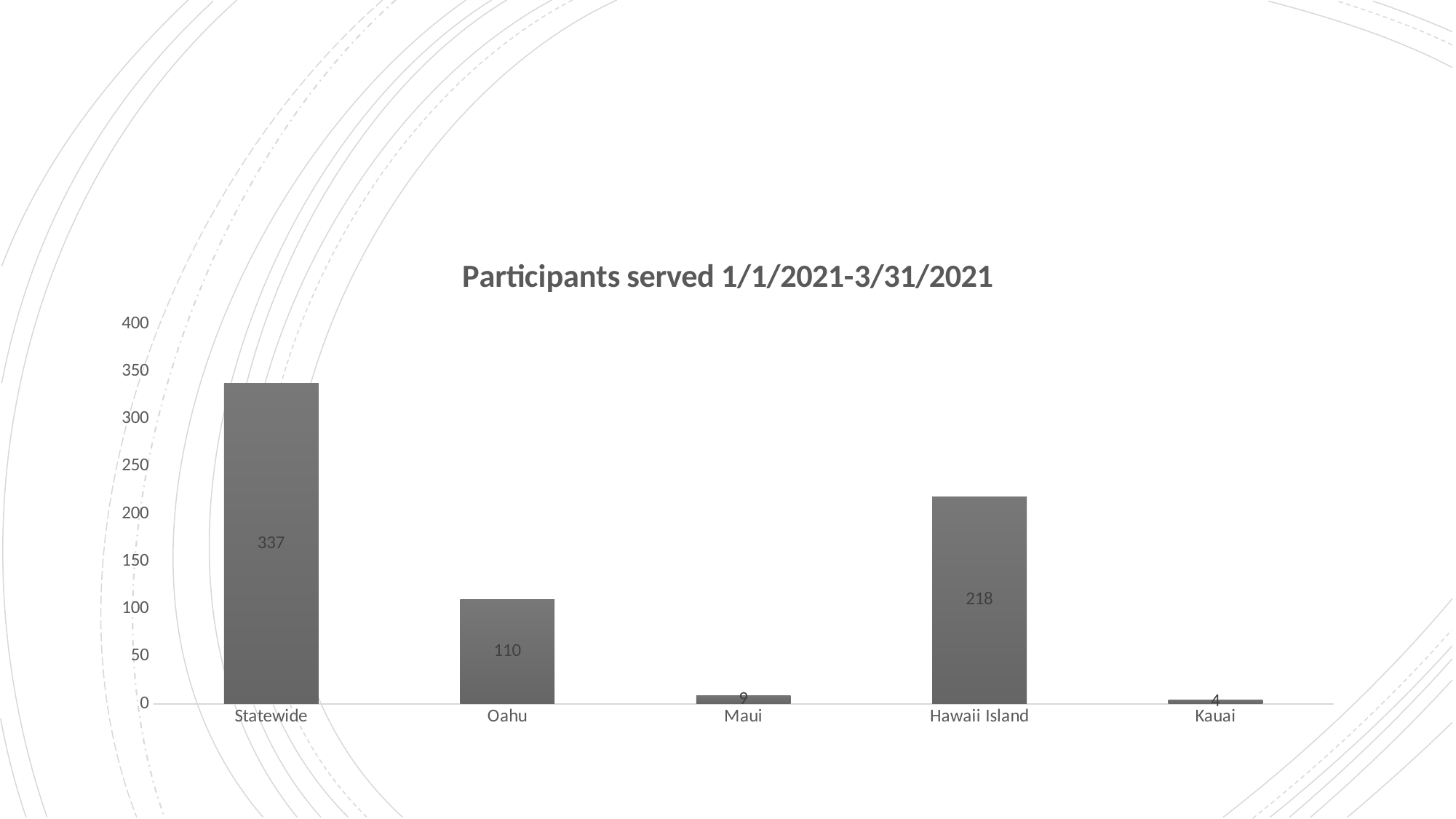
Which is larger, the value for Oahu or the value for Hawaii Island? Hawaii Island Is the value for Statewide greater or less than 300? greater What is the difference between the values for Hawaii Island and Oahu? 108 What is the value for Kauai? 4 What is the value for Statewide? 337 What is the value for Maui? 9 How many categories are shown on the x axis? 5 Which category has the highest value? Statewide What is the value for Oahu? 110 What is the title of the chart? Participants served 1/1/2021-3/31/2021 What is the value for Hawaii Island? 218 Which category has the lowest value? Kauai